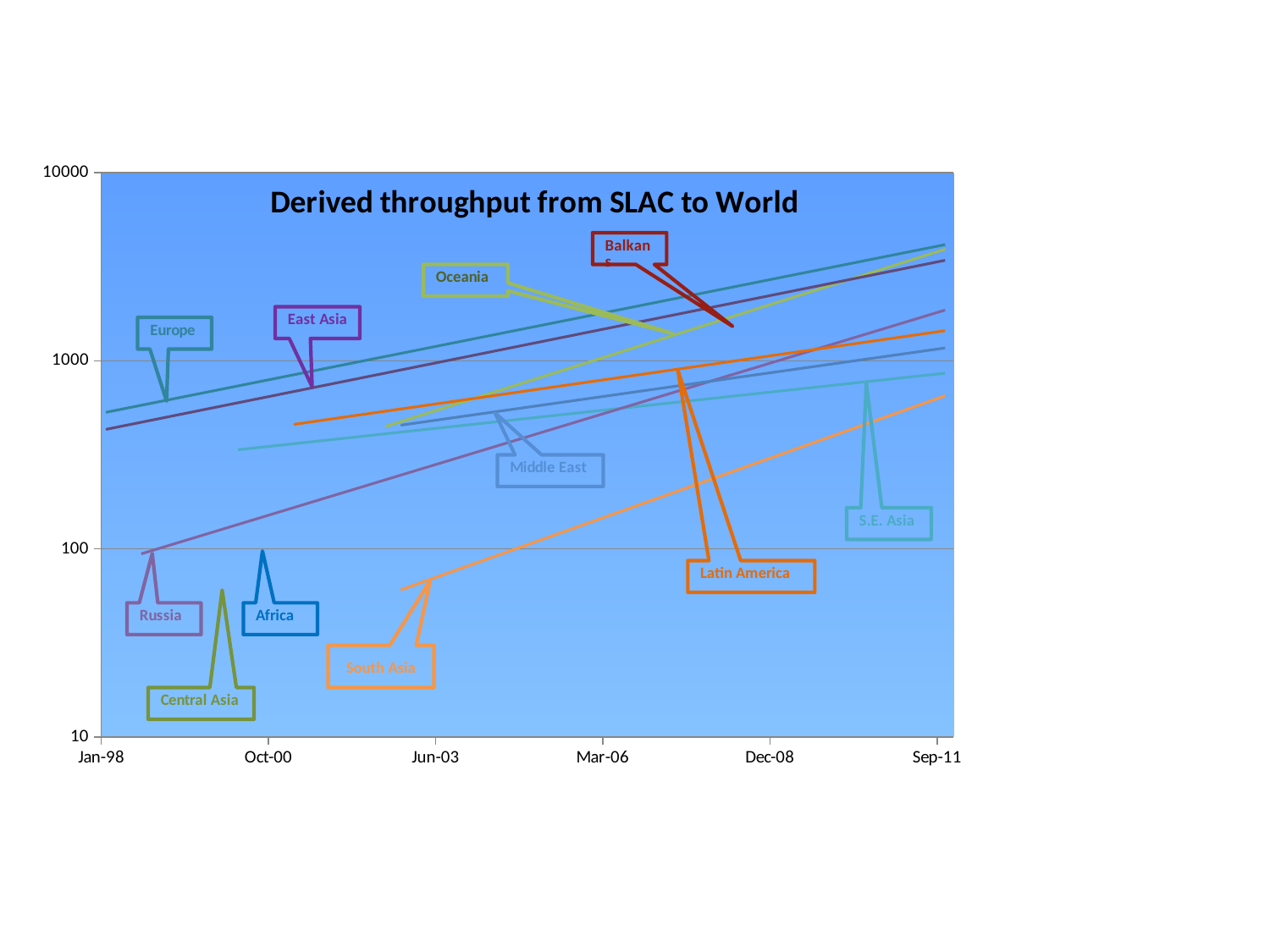
Do the plotted lines rise or fall from left to right along the x axis? rise Which region's line has the lowest values on the chart? South Asia How many regions are labelled with callouts on the chart? 11 At Sep-11, which line is higher: Europe or South Asia? Europe What is the title of the chart? Derived throughput from SLAC to World What kind of chart is shown on the slide? line chart Is the value of the Europe line at Jan-98 greater or less than 100? greater What is the last date label on the x axis? Sep-11 Is the value of the Latin America line at Sep-11 greater or less than 1000? greater Is the value of the Europe line at Sep-11 greater or less than 1000? greater What is the highest value shown on the y axis? 10000